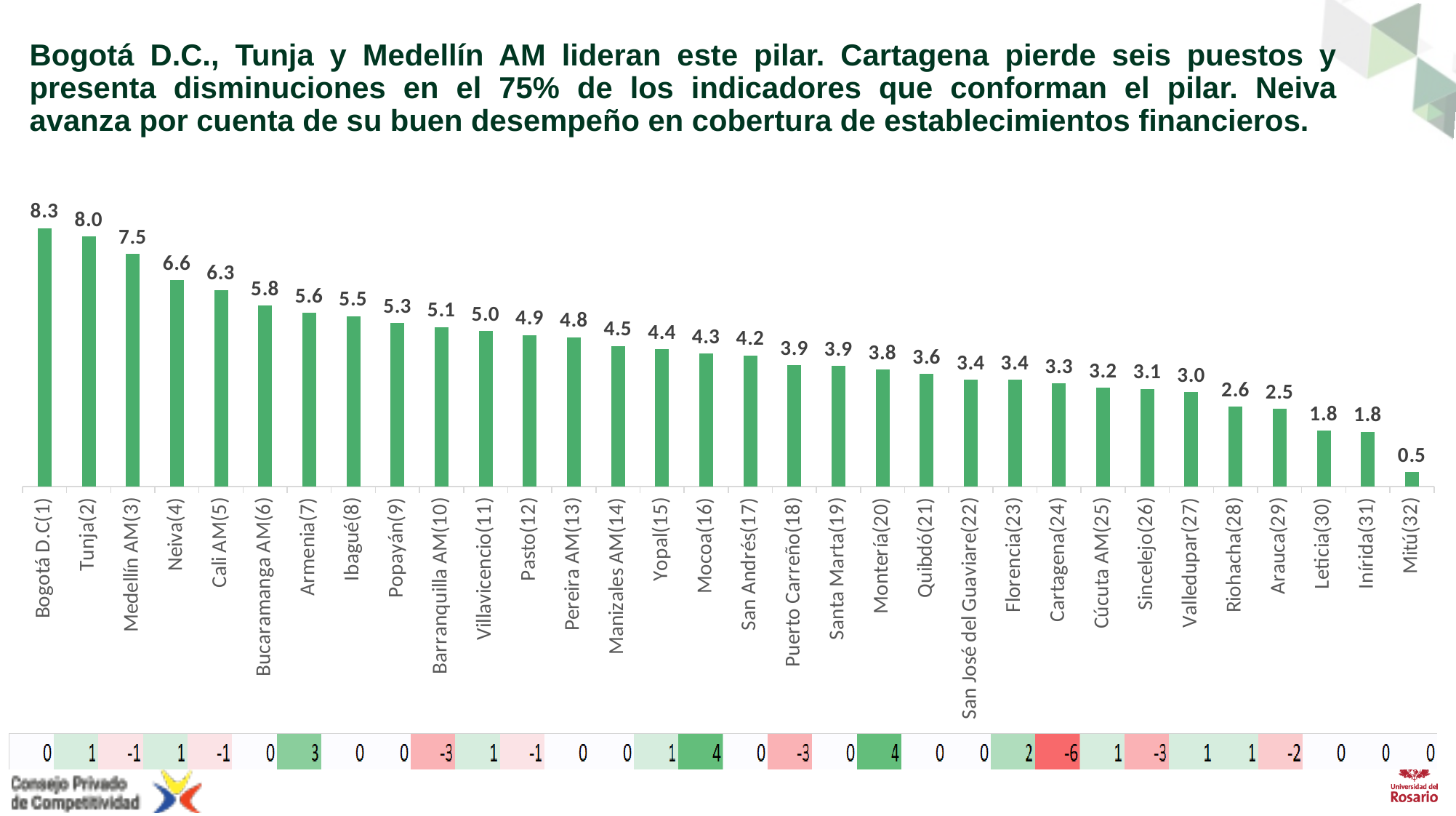
What is the value for Bogotá D.C(1)? 8.3 Which city has the lowest value in the chart? Mitú(32) What is the value for Cartagena(24)? 3.3 What is the value for Neiva(4)? 6.6 Which has a larger value, Cali AM(5) or Bucaramanga AM(6)? Cali AM(5) Do the values rise or fall from left to right along the x axis? Fall What is the difference between the values for Tunja(2) and Medellín AM(3)? 0.5 What is the value for Mitú(32)? 0.5 Which city has the highest value in the chart? Bogotá D.C(1) How many cities are shown in the bar chart? 32 What kind of chart is shown on the slide? Bar chart What is the difference between the values for Bogotá D.C(1) and Mitú(32)? 7.8